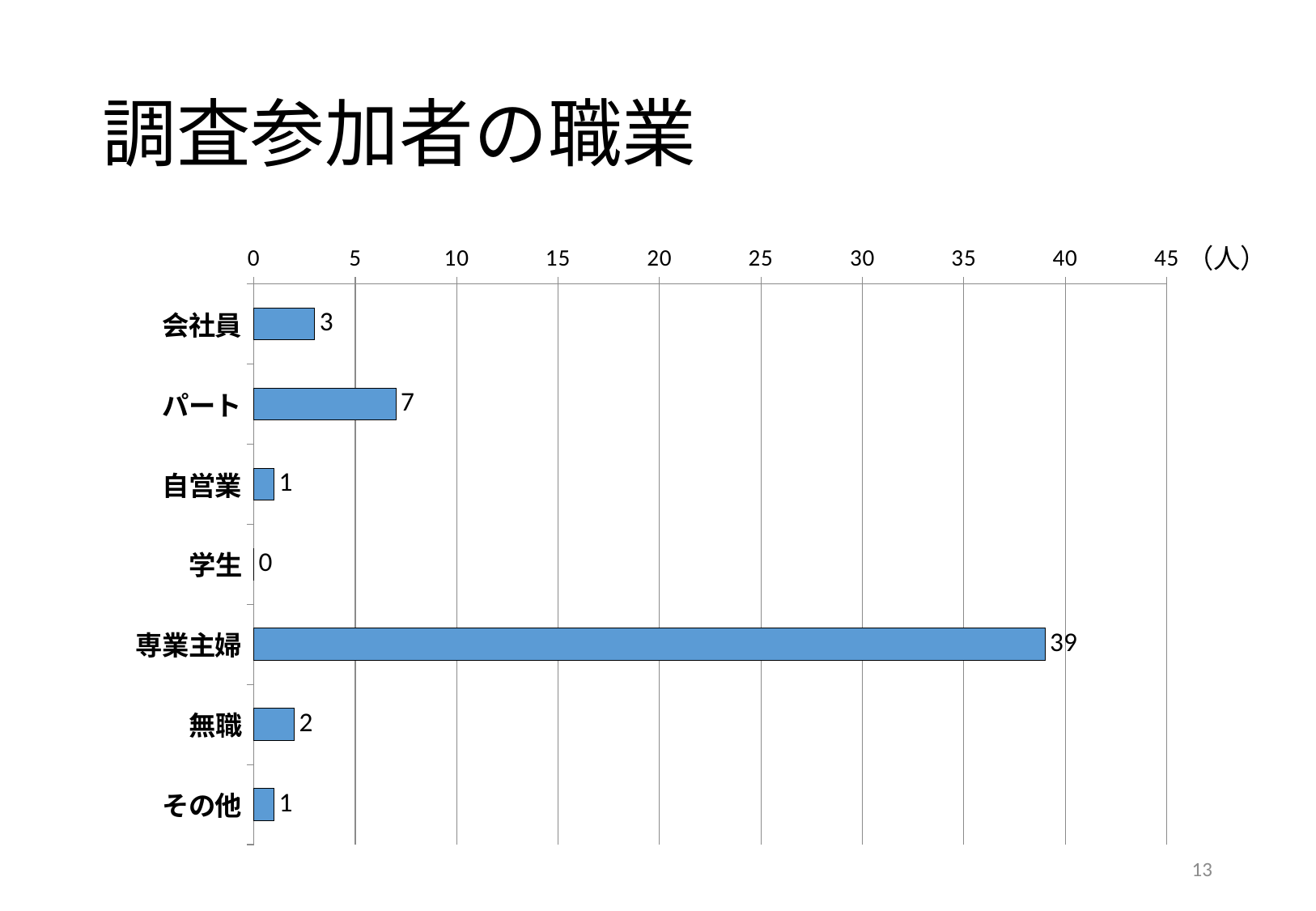
Which is larger, the value for 会社員 or the value for 無職? 会社員 Which category has the lowest value? 学生 What is the value for 会社員? 3 How many categories are shown in the chart? 7 What is the difference between the values for 専業主婦 and パート? 32 What kind of chart is shown on the slide? bar chart Is the value for 専業主婦 greater or less than 35? greater What is the value for 学生? 0 Which category has the highest value? 専業主婦 What is the value for パート? 7 What is the title of the slide? 調査参加者の職業 What is the value for 専業主婦? 39